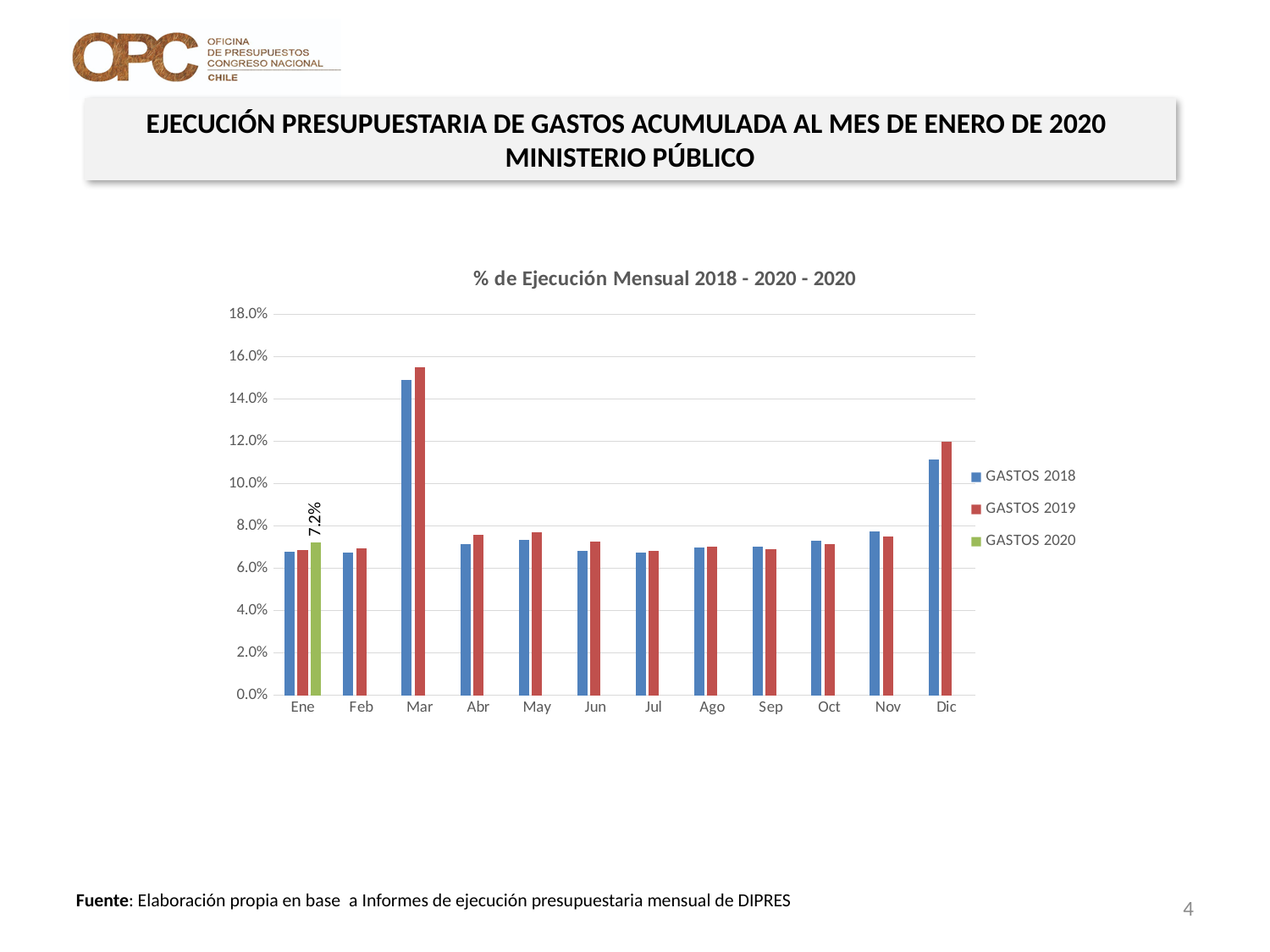
Is the value of GASTOS 2019 for Mar greater or less than 14.0%? greater In which month is GASTOS 2018 highest? Mar What colour represents GASTOS 2020 in the legend? Green How many series does the legend list? 3 What is the title of the chart? % de Ejecución Mensual 2018 - 2020 - 2020 Is the value of GASTOS 2018 for Feb greater or less than 8.0%? less What kind of chart is shown on the slide? Bar chart How many months are shown on the x axis? 12 For Dic, which is larger: GASTOS 2018 or GASTOS 2019? GASTOS 2019 What is the value of GASTOS 2020 for Ene? 7.2% In which month is GASTOS 2019 highest? Mar Is the value of GASTOS 2018 for Dic greater or less than 10.0%? greater